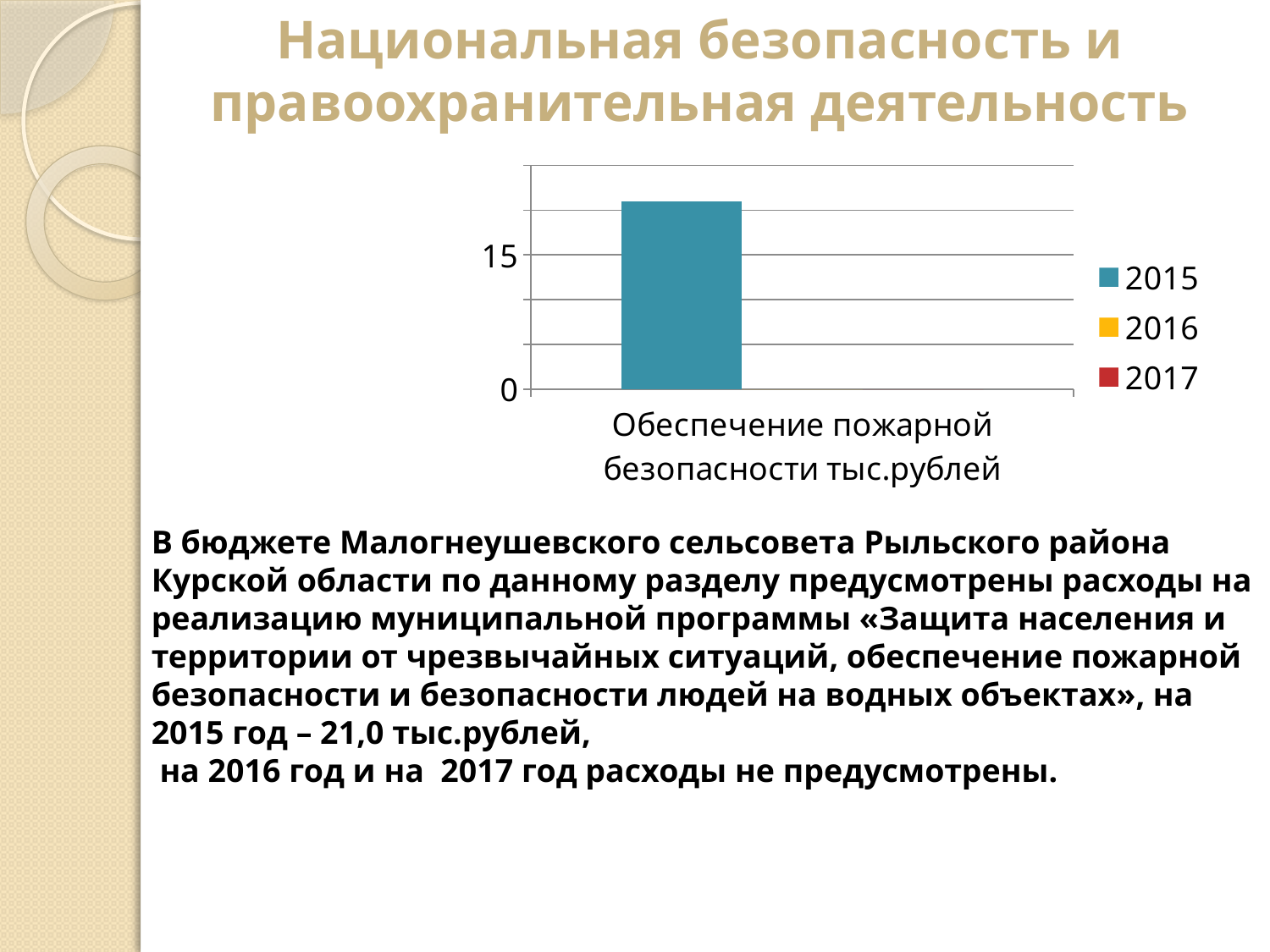
Which series has the highest value in the chart? 2015 What is the category label shown on the x axis of the chart? Обеспечение пожарной безопасности тыс.рублей What is the highest labelled tick on the y axis of the chart? 15 What colour is the bar for 2015 in the chart? blue Which is larger in the chart, the value for 2015 or the value for 2017? 2015 How many series does the legend list? 3 What kind of chart is shown on the slide? bar chart How many categories are shown on the x axis of the chart? 1 Is the value for 2015 in the chart greater or less than 15? greater Is the value for 2016 in the chart greater or less than 15? less What are the entries listed in the chart's legend? 2015, 2016, 2017